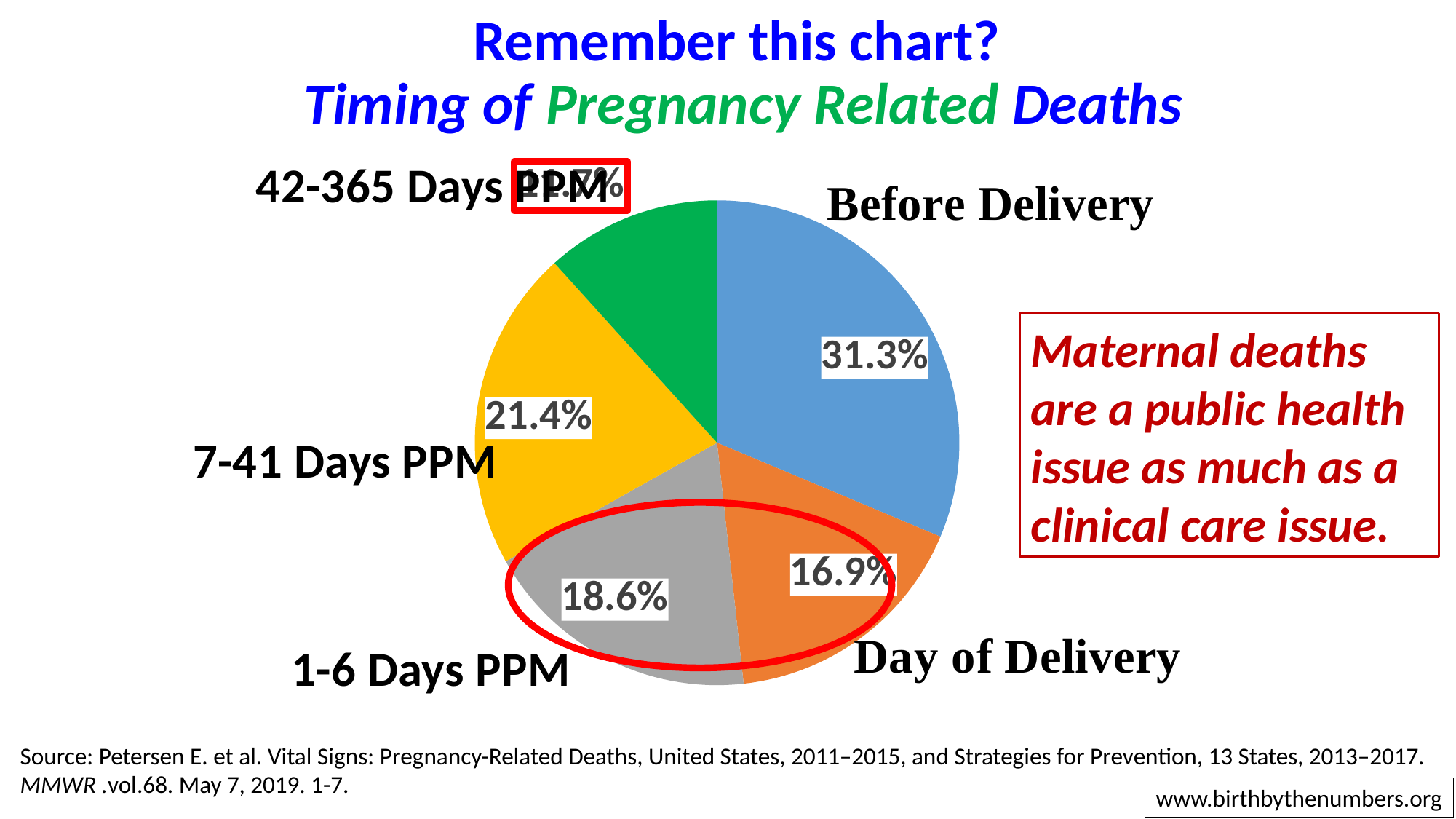
Which timing category accounts for the smallest share of pregnancy related deaths? 42-365 Days PPM How many percentage points larger is the Before Delivery share than the Day of Delivery share? 14.4 percentage points Which is larger: the share for 1-6 Days PPM or the share for Day of Delivery? 1-6 Days PPM What is the difference between the 7-41 Days PPM share and the 1-6 Days PPM share? 2.8 percentage points What is the value shown for the 1-6 Days PPM slice? 18.6% What is the combined share of the two circled slices, 1-6 Days PPM and Day of Delivery? 35.5% What type of chart is shown on the slide? Pie chart How many slices does the pie chart have? 5 What percentage of pregnancy related deaths occurred on the Day of Delivery? 16.9% What percentage of pregnancy related deaths occurred Before Delivery? 31.3% Which timing category accounts for the largest share of pregnancy related deaths? Before Delivery What is the value shown for the 7-41 Days PPM slice? 21.4%